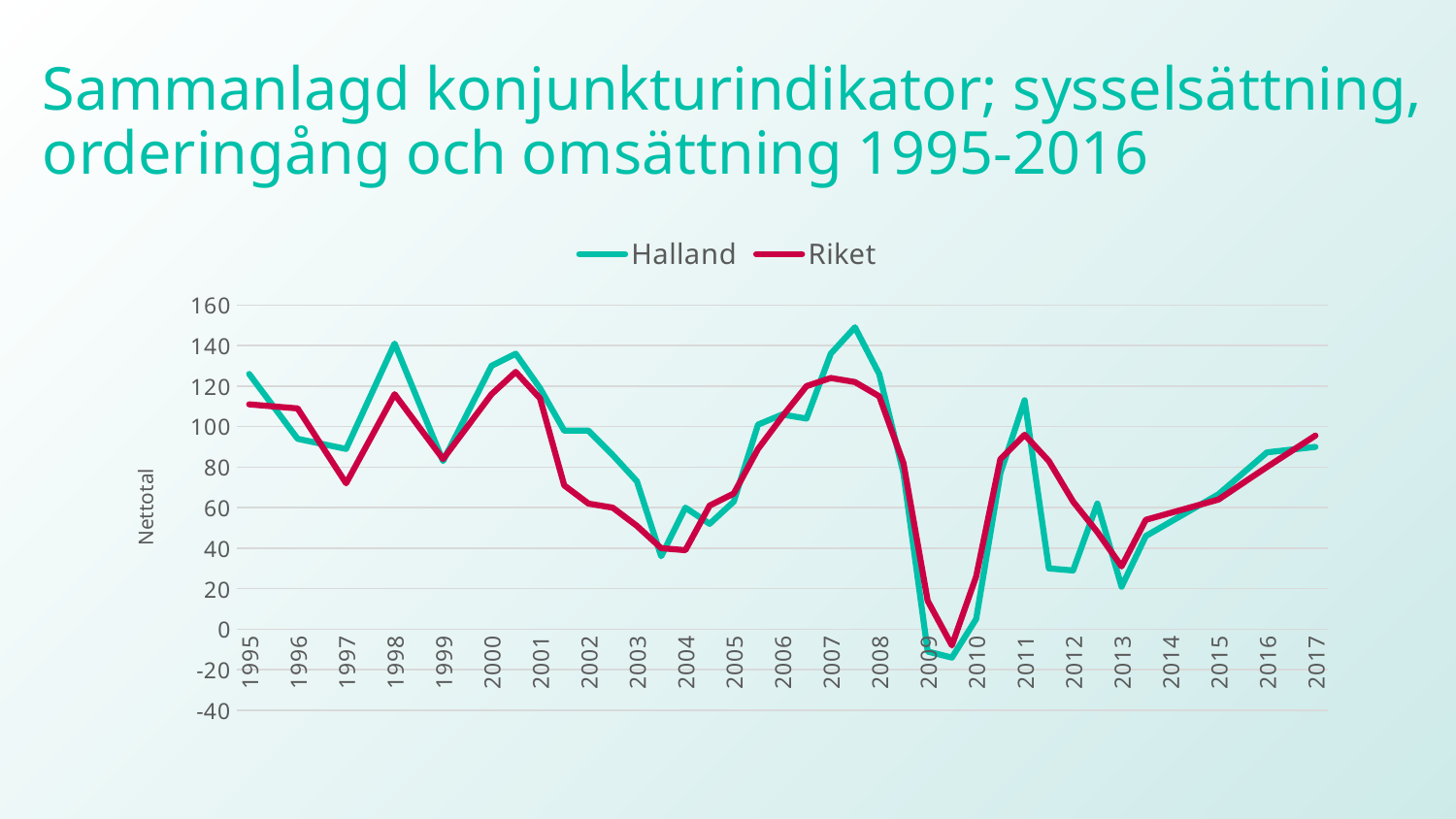
What kind of chart is shown on the slide? line chart Around which year does the Halland line reach its lowest point? 2009 Is the value for Halland at 1995 greater or less than 100? greater At 2002, which series has the higher value, Halland or Riket? Halland What is the label on the vertical axis? Nettotal Is the value for Riket at 2017 greater or less than 80? greater What are the two series named in the legend? Halland and Riket How many series does the legend list? 2 Do the values for Riket rise or fall from 2013 to 2017? rise How many year labels are shown along the x axis? 23